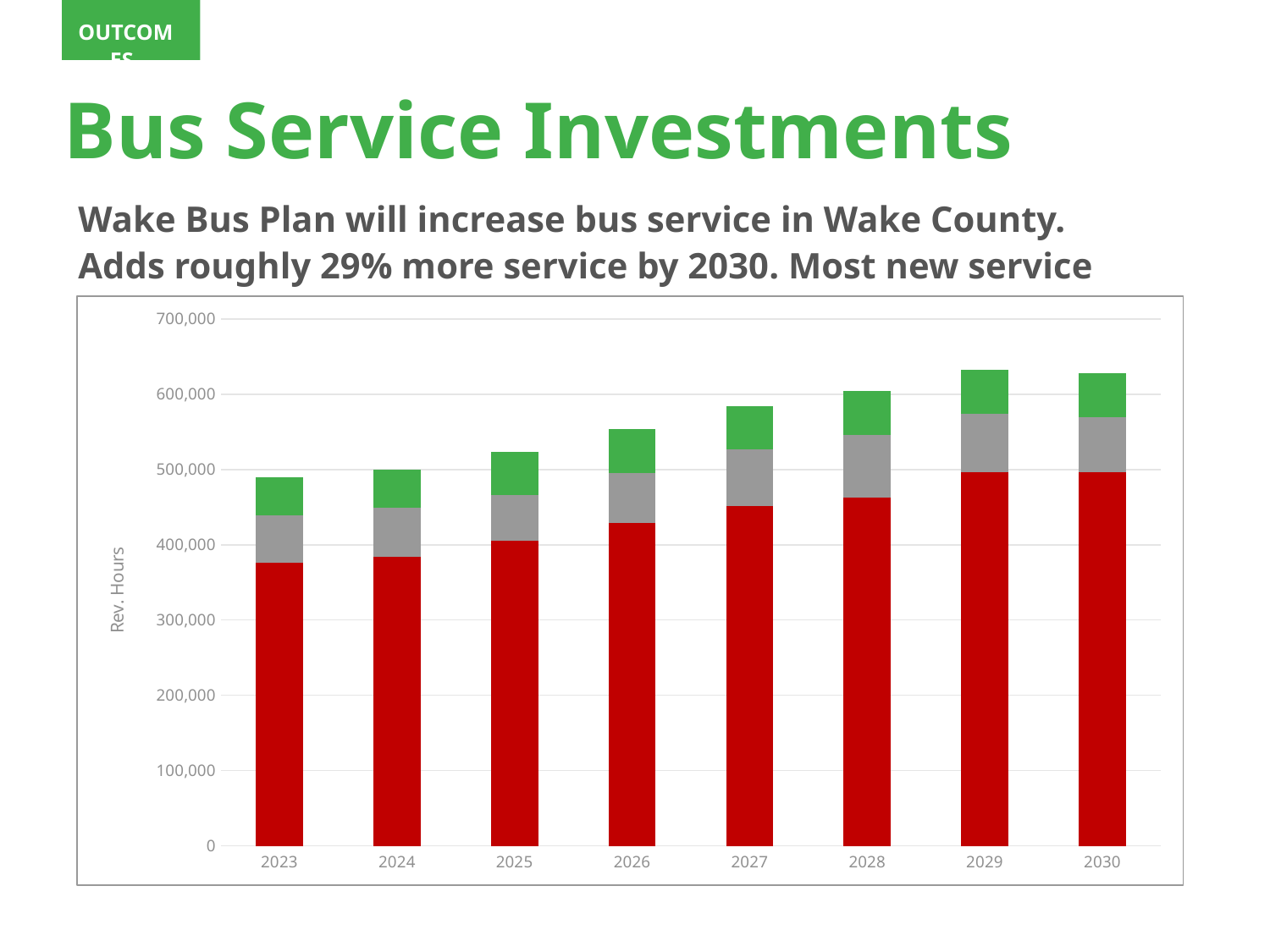
How many stacked segments make up each bar in the chart? 3 Is the total bar height for 2027 greater or less than 600,000? less Is the total bar height for 2029 greater or less than 600,000? greater Is the red segment for 2023 greater or less than 400,000? less Which year has the lowest total bar height? 2023 Do the total bar heights generally rise or fall from 2023 to 2029? rise What kind of chart is shown on the slide? stacked bar chart How many years are shown on the x axis of the chart? 8 Which year has the larger total bar height, 2026 or 2028? 2028 What is the label of the vertical axis? Rev. Hours